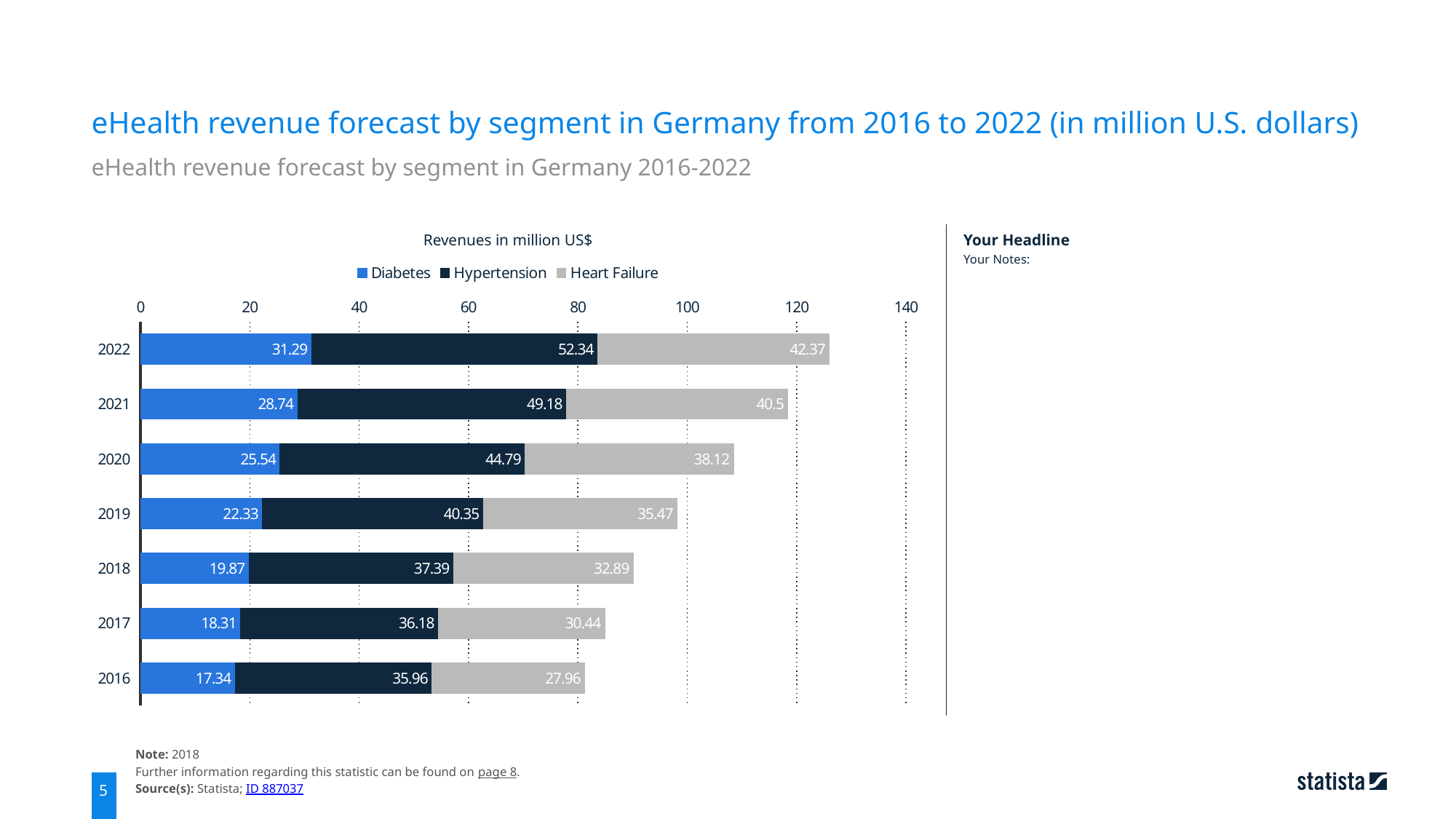
What is the Diabetes revenue forecast for 2022? 31.29 What is the difference between the Hypertension forecast for 2022 and for 2016? 16.38 How many series does the legend list? 3 Which year has the lowest Heart Failure revenue forecast? 2016 How many years are shown on the chart? 7 What is the total revenue forecast across all three segments for 2022? 126 Which is larger in 2018: the Hypertension forecast or the Heart Failure forecast? Hypertension What is the Heart Failure revenue forecast for 2021? 40.5 What is the Hypertension revenue forecast for 2019? 40.35 Which year has the highest Diabetes revenue forecast? 2022 What kind of chart is shown on the slide? Stacked bar chart Which segment is shown in light grey in the legend? Heart Failure